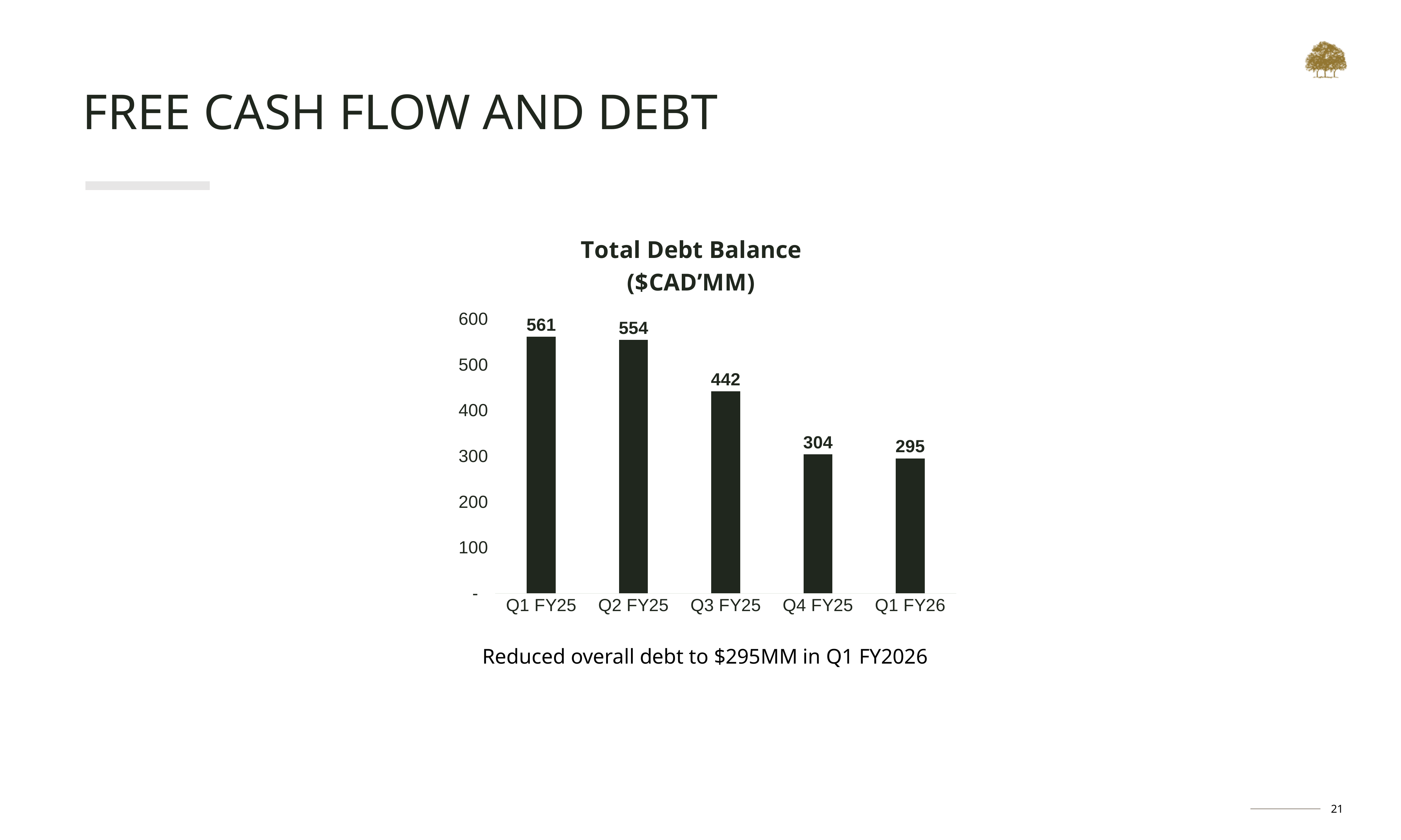
What is the total debt balance for Q3 FY25? 442 Which is larger, the total debt balance in Q2 FY25 or in Q4 FY25? Q2 FY25 Does the total debt balance rise or fall from Q1 FY25 to Q1 FY26? fall What kind of chart is used to show the Total Debt Balance? bar chart Which quarter has the lowest total debt balance? Q1 FY26 What is the total debt balance for Q1 FY26? 295 What is the difference in total debt balance between Q3 FY25 and Q4 FY25? 138 What is the total debt balance for Q1 FY25? 561 Which quarter has the highest total debt balance? Q1 FY25 How many quarters are shown in the Total Debt Balance chart? 5 What is the difference in total debt balance between Q1 FY25 and Q1 FY26? 266 Is the total debt balance for Q4 FY25 greater or less than 400? less